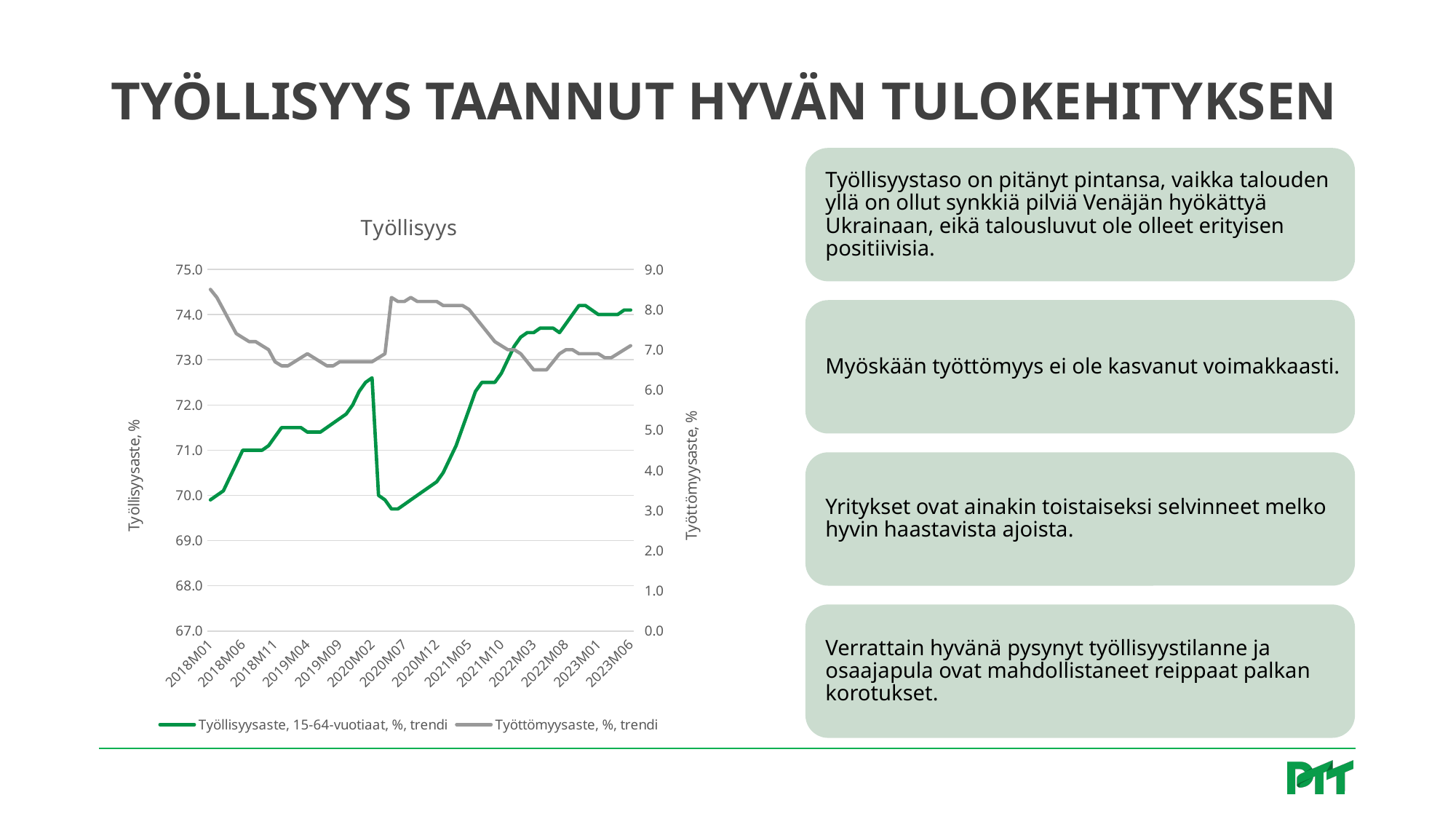
Is the value of Työllisyysaste, 15-64-vuotiaat, %, trendi at 2020M02 greater or less than 72.0? greater Does Työttömyysaste, %, trendi rise or fall between 2020M07 and 2022M03? fall What kind of chart is shown on the slide? line chart Which is larger for Työllisyysaste, 15-64-vuotiaat, %, trendi: the value at 2020M02 or at 2020M07? 2020M02 Which colour is the line for Työttömyysaste, %, trendi? grey How many series does the legend of the Työllisyys chart list? 2 Is the value of Työttömyysaste, %, trendi at 2022M03 greater or less than 7.0? less Does Työllisyysaste, 15-64-vuotiaat, %, trendi rise or fall between 2020M07 and 2023M06? rise Is the value of Työllisyysaste, 15-64-vuotiaat, %, trendi at 2023M06 greater or less than 73.0? greater What is the title of the chart on the slide? Työllisyys How many x-axis tick labels are shown on the Työllisyys chart? 14